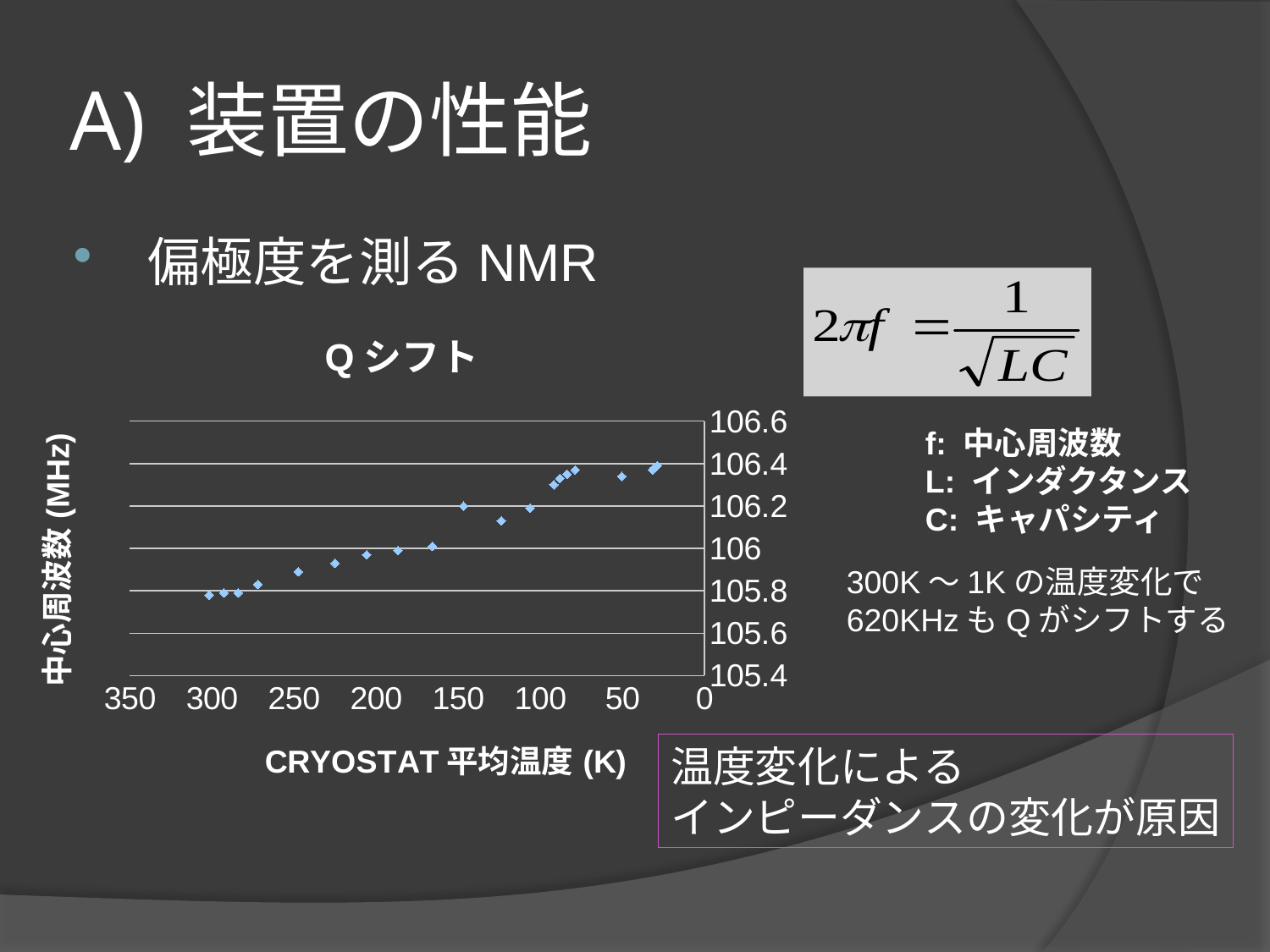
Do the plotted values rise or fall moving from left to right along the x axis? rise What is the title of the chart? Qシフト Is the value for the point near 25 K greater or less than 106.6? less Is the value for the point at 300 K greater or less than 106? less Is the value for the point at 300 K greater or less than 105.6? greater What kind of chart is shown on the slide? scatter chart What is the highest tick value shown on the y axis? 106.6 What is the label of the x axis of the chart? CRYOSTAT 平均温度 (K) Which has the higher center frequency, the point at 300 K or the point at 50 K? 50 K